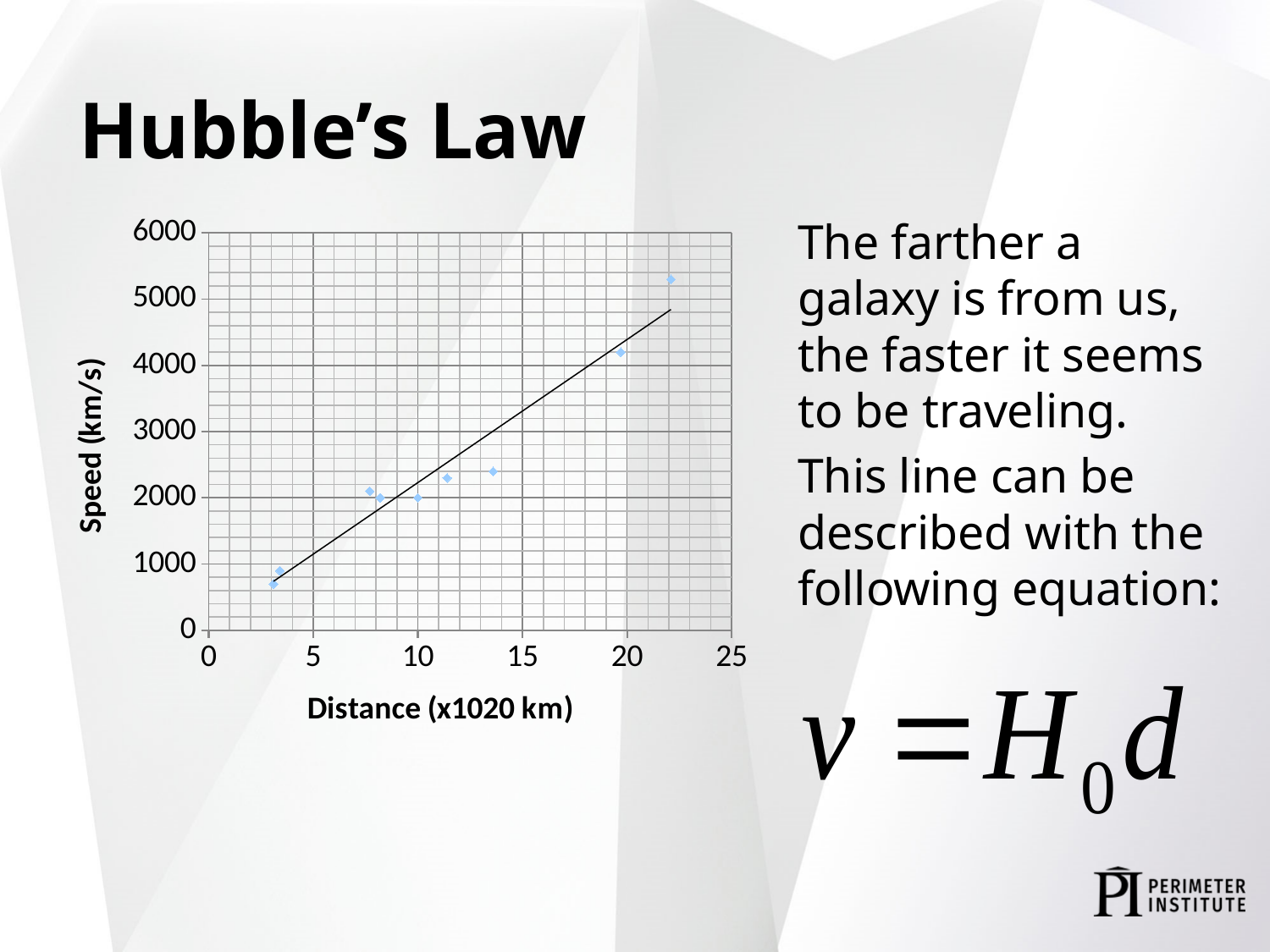
Is the speed of the point plotted at a distance of 10 greater or less than 3000? less Is the speed of the point plotted near a distance of 20 greater or less than 4000? greater Which has the lower speed: the point near a distance of 3 or the point near a distance of 10? the point near a distance of 3 Which has the higher speed: the point near a distance of 20 or the point near a distance of 14? the point near a distance of 20 What is the maximum value shown on the y axis? 6000 Are the speeds of the points plotted near a distance of 3 greater or less than 1000? less Do the plotted speeds rise or fall as distance increases along the x axis? rise What kind of chart is shown on the slide? scatter chart What is the title of the chart's x axis? Distance (x1020 km) What is the title of the chart's y axis? Speed (km/s)